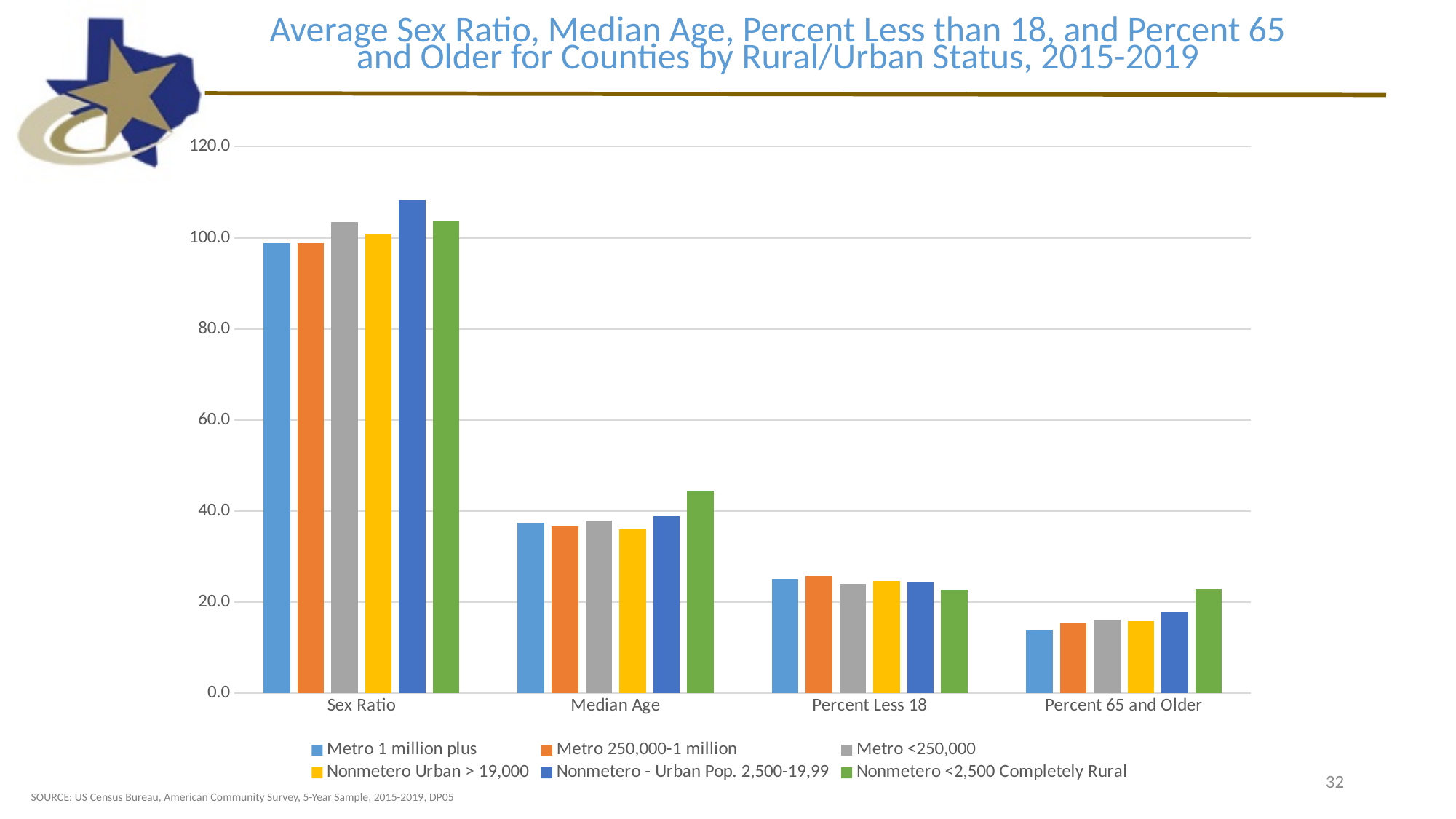
Which series has the lowest value for Percent 65 and Older? Metro 1 million plus Is the Median Age value for Nonmetero <2,500 Completely Rural greater or less than 40.0? greater How many series does the chart's legend list? 6 Is the Percent 65 and Older value for Metro 1 million plus greater or less than 20.0? less How many categories are shown on the x axis of the chart? 4 Is the Sex Ratio value for Nonmetero - Urban Pop. 2,500-19,99 greater or less than 100.0? greater Which series has the highest value for Median Age? Nonmetero <2,500 Completely Rural For Median Age, which is larger: Metro 1 million plus or Nonmetero <2,500 Completely Rural? Nonmetero <2,500 Completely Rural Which series has the highest value for Percent 65 and Older? Nonmetero <2,500 Completely Rural What kind of chart is shown on the slide? bar chart Which series has the lowest value for Percent Less 18? Nonmetero <2,500 Completely Rural Which series has the highest value for Sex Ratio? Nonmetero - Urban Pop. 2,500-19,99